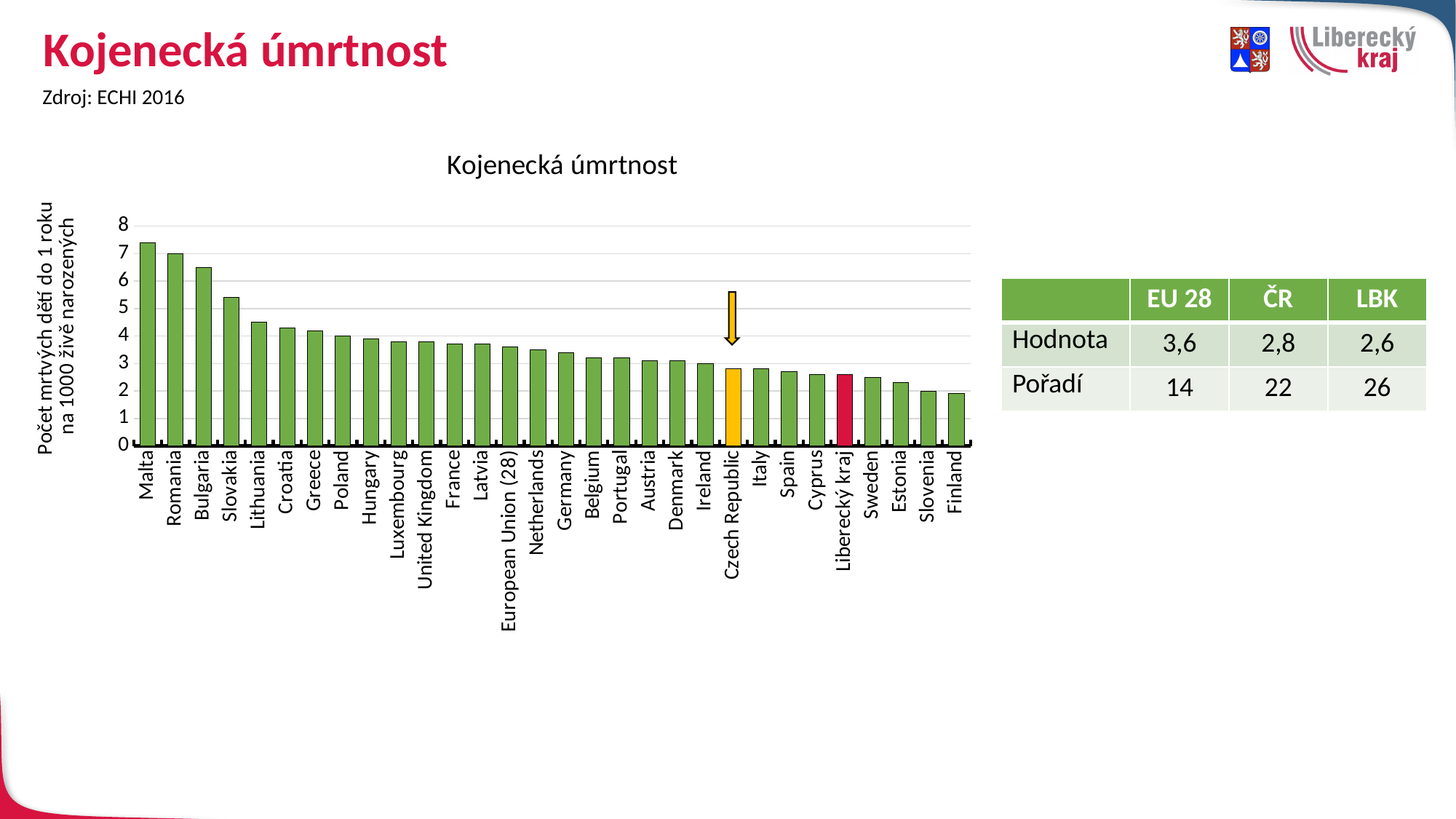
What colour is the bar for Liberecký kraj? red According to the table, what is the value (Hodnota) for the Czech Republic (ČR)? 2,8 According to the table, what is the value (Hodnota) for Liberecký kraj (LBK)? 2,6 Do the values rise or fall moving from left to right along the x axis? fall Is the value for Estonia greater or less than 3? less Is the value for Lithuania greater or less than 4? greater How many categories (bars) are plotted in the chart? 30 What type of chart is shown on the slide? bar chart What is the title of the chart? Kojenecká úmrtnost Is the value for Malta greater or less than 7? greater Which has the larger value, Romania or Bulgaria? Romania Which country has the highest infant mortality value in the chart? Malta